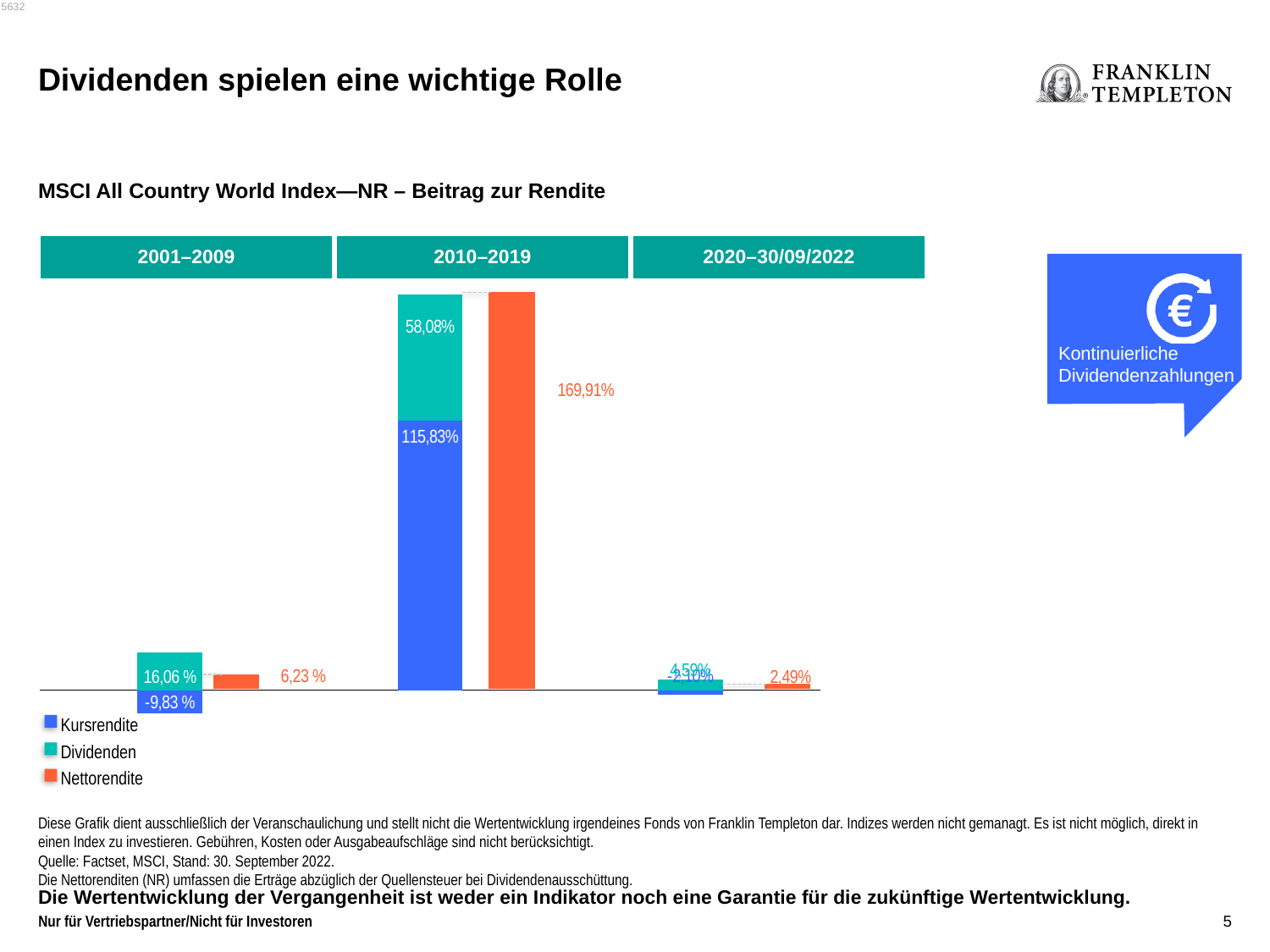
What kind of chart is shown on the slide? bar chart What is the Nettorendite value for the period 2001–2009? 6,23 % What is the Dividenden value for the period 2010–2019? 58,08% What is the Nettorendite value for the period 2010–2019? 169,91% How many time periods are shown on the chart? 3 How many series does the legend list? 3 What is the Kursrendite value for the period 2001–2009? -9,83 % What is the Nettorendite value for the period 2020–30/09/2022? 2,49% What is the Dividenden value for the period 2001–2009? 16,06 % What is the Kursrendite value for the period 2010–2019? 115,83% Which period has the highest Nettorendite? 2010–2019 Which is larger for 2010–2019, Kursrendite or Dividenden? Kursrendite